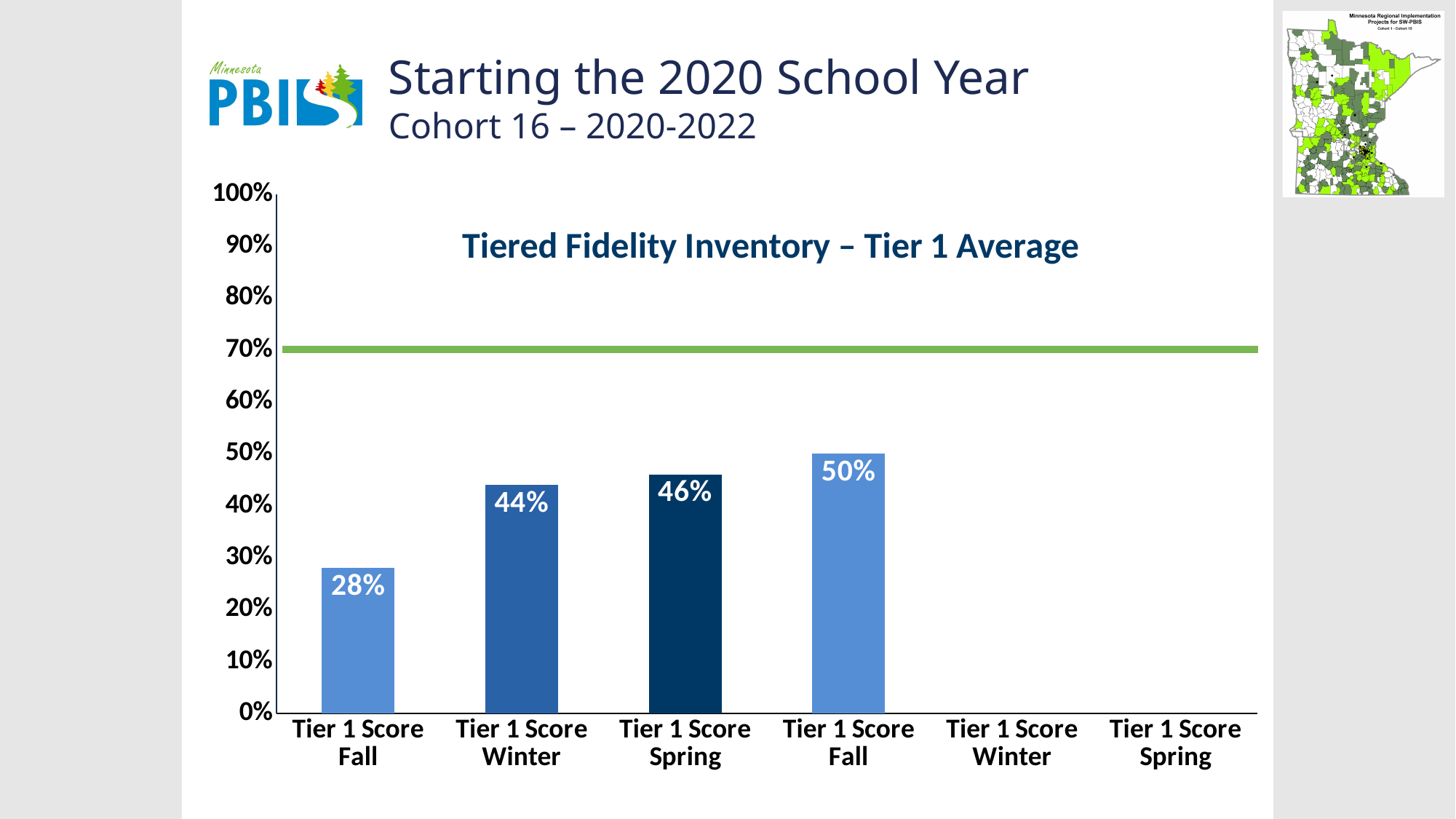
What is the difference between the 50% bar and the 28% bar? 22% How many category labels are shown on the x axis? 6 Is the value of the highest bar greater or less than 70%? less What kind of chart is shown on the slide? Bar chart What is the title of the chart? Tiered Fidelity Inventory – Tier 1 Average Which bar has the lowest value? The first Tier 1 Score Fall (leftmost bar), 28% What is the value of the 'Tier 1 Score Spring' bar that has a data label? 46% What is the value of the first 'Tier 1 Score Fall' bar (the leftmost bar)? 28% What is the value of the 'Tier 1 Score Winter' bar that has a data label? 44% What is the value of the fourth bar from the left (the second 'Tier 1 Score Fall')? 50% Which bar has the highest value? The second Tier 1 Score Fall (fourth bar), 50% Which is larger, the Tier 1 Score Winter bar or the Tier 1 Score Spring bar? Tier 1 Score Spring